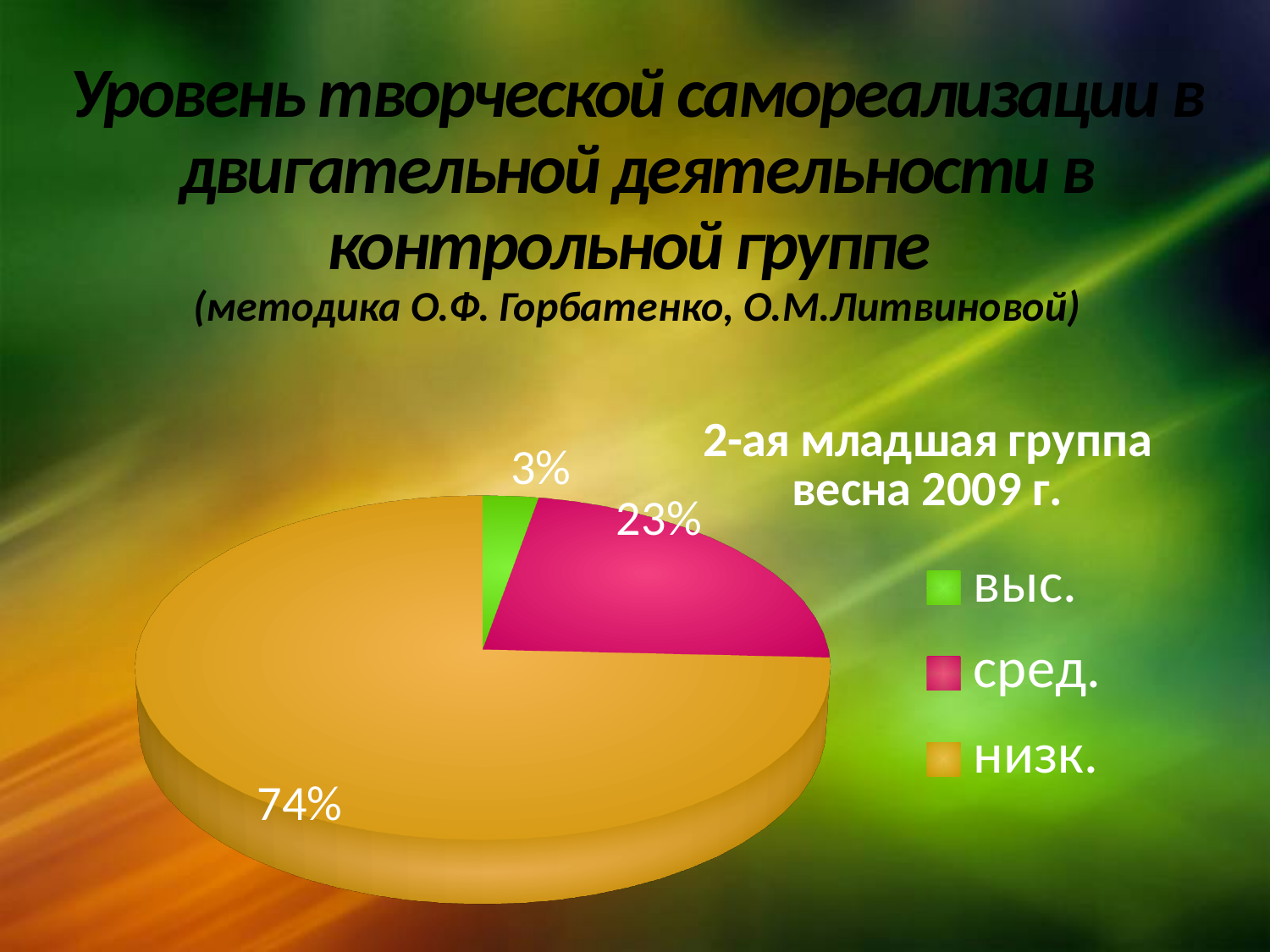
What colour is the "сред." slice in the legend? magenta (pink) How many slices does the pie chart have? 3 What is the difference in percentage points between the "сред." and "выс." slices? 20 Which is larger, the "сред." slice or the "выс." slice? сред. What share of the pie does the "низк." slice represent? 74% Which category has the smallest slice of the pie? выс. Which category has the largest slice of the pie? низк. What kind of chart is shown on the slide? pie chart What share of the pie does the "сред." slice represent? 23% What is the difference in percentage points between the "низк." and "сред." slices? 51 What share of the pie does the "выс." slice represent? 3% What is the title of the chart? 2-ая младшая группа весна 2009 г.